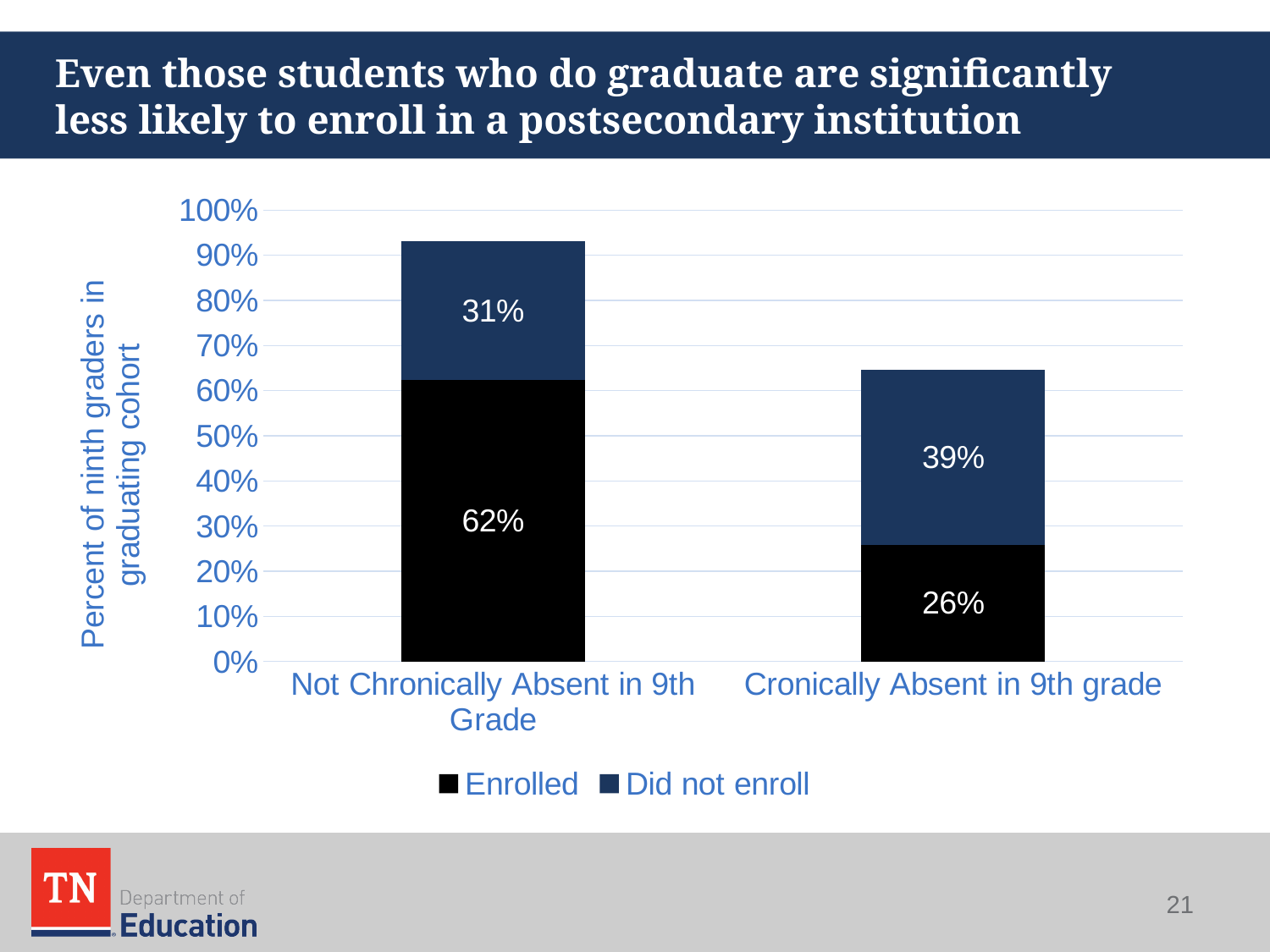
What is the 'Did not enroll' value for the 'Not Chronically Absent in 9th Grade' category? 31% What kind of chart is shown on the slide? Stacked bar chart What percentage of students who were chronically absent in 9th grade enrolled? 26% Which category has the higher 'Enrolled' value? Not Chronically Absent in 9th Grade Which category has the lower 'Did not enroll' value? Not Chronically Absent in 9th Grade What is the total of the stacked bar for 'Not Chronically Absent in 9th Grade'? 93% What percentage of students who were not chronically absent in 9th grade enrolled in a postsecondary institution? 62% What is the difference between the 'Enrolled' values for the two categories? 36% How many categories are shown on the x axis? 2 What is the 'Did not enroll' value for the 'Cronically Absent in 9th grade' category? 39% What is the total of the stacked bar for 'Cronically Absent in 9th grade'? 65% How many series does the legend list? 2